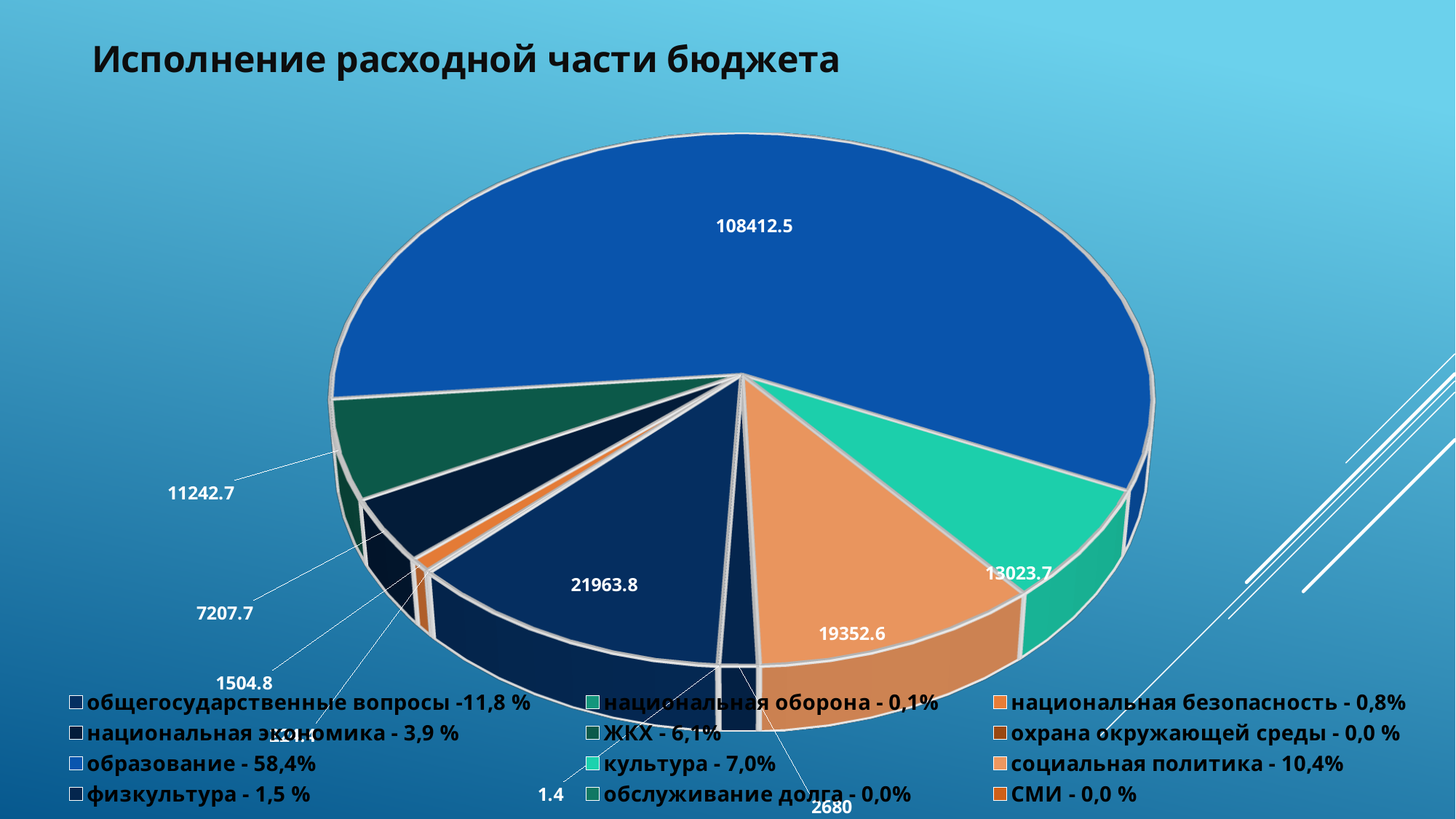
What kind of chart is shown on the slide? pie chart Which slice is larger, социальная политика or культура? социальная политика What share of the pie does социальная политика account for, according to the legend? 10,4% What is the data label for the культура slice? 13023.7 What share of the pie does образование account for, according to the legend? 58,4% How many categories does the legend list? 12 Which category has the largest slice of the pie? образование What is the data label for the ЖКХ slice? 11242.7 What is the data label on the largest slice (образование)? 108412.5 What is the title of the chart? Исполнение расходной части бюджета What is the data label for the социальная политика slice? 19352.6 What is the difference between the образование value (108412.5) and the общегосударственные вопросы value (21963.8)? 86448.7